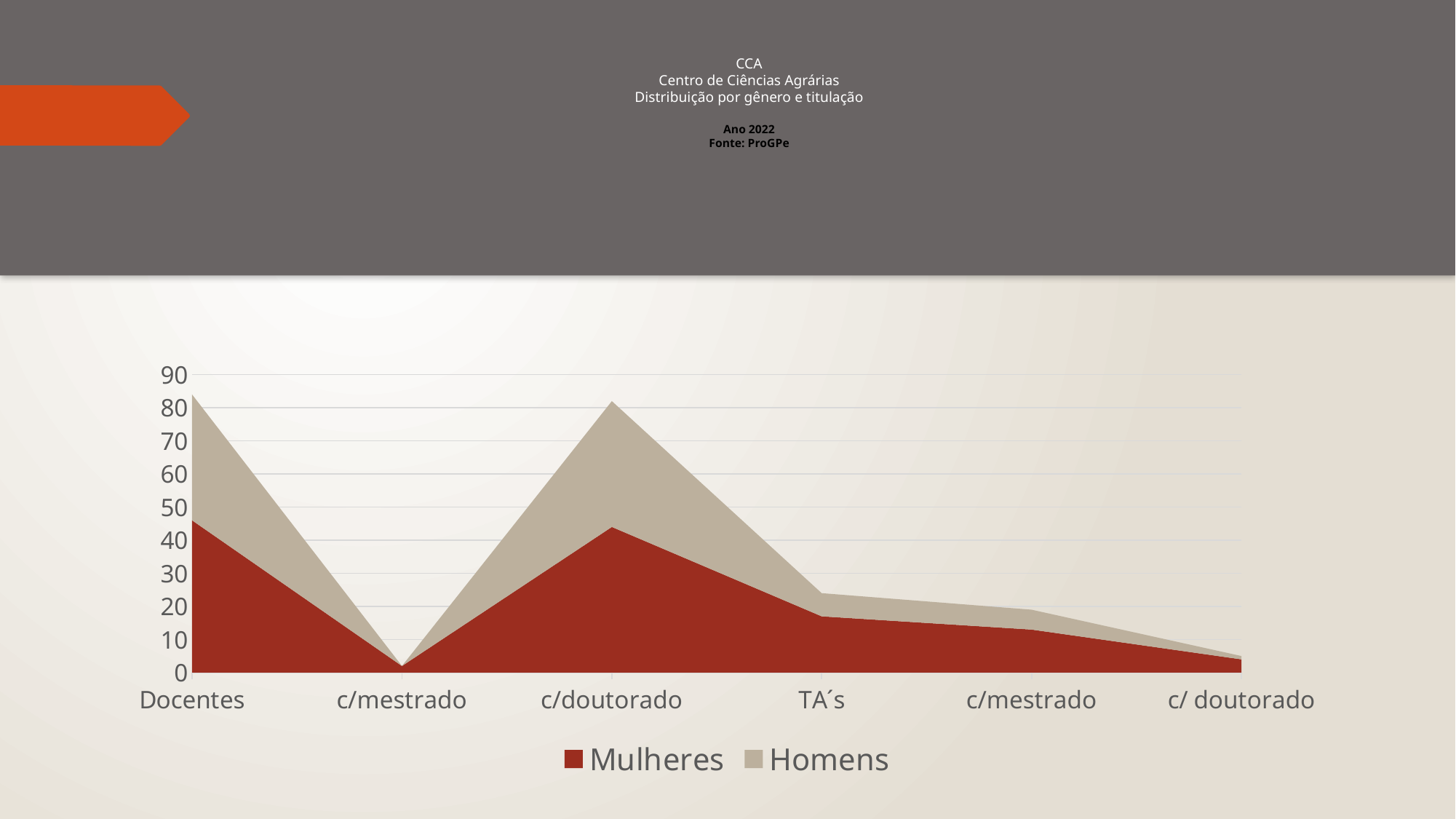
Is the value for Mulheres at TA´s greater or less than 20? less Is the stacked total (Mulheres plus Homens) at Docentes greater or less than 70? greater What kind of chart is shown on the slide? Area chart How many series does the legend list? 2 Is the value for Mulheres at Docentes larger or smaller than the value for Mulheres at TA´s? larger Is the value for Mulheres at Docentes greater or less than 40? greater How many categories are shown along the x axis? 6 Which colour represents the Mulheres series? Dark red Which series are listed in the chart legend? Mulheres and Homens